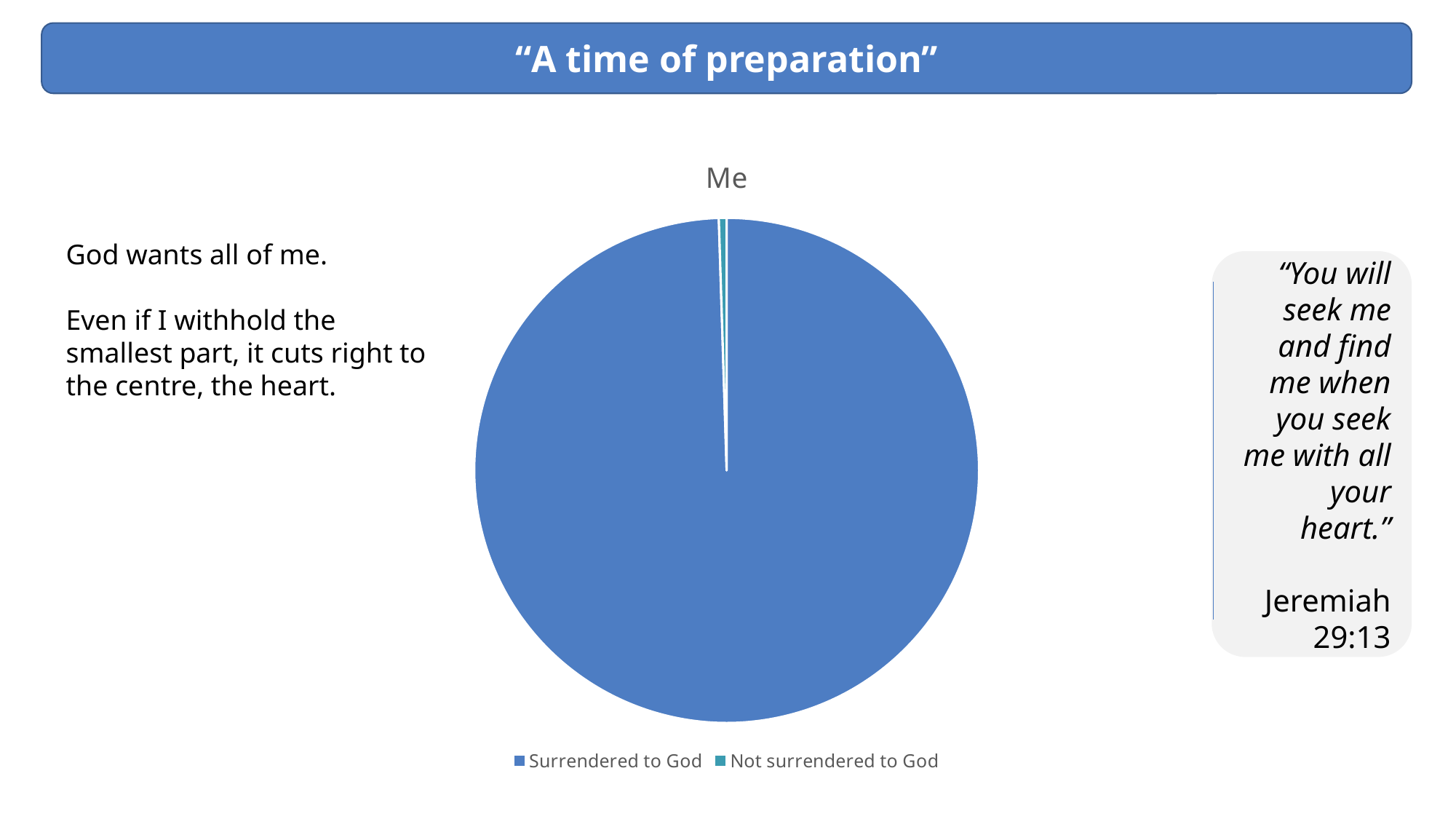
What kind of chart is shown on the slide? pie chart Which category takes up the largest share of the pie? Surrendered to God Which slice is larger, Surrendered to God or Not surrendered to God? Surrendered to God How many categories does the legend of the chart list? 2 What colour is the slice for Surrendered to God? blue Which category takes up the smallest share of the pie? Not surrendered to God How many slices does the pie chart have? 2 What is the title of the chart? Me